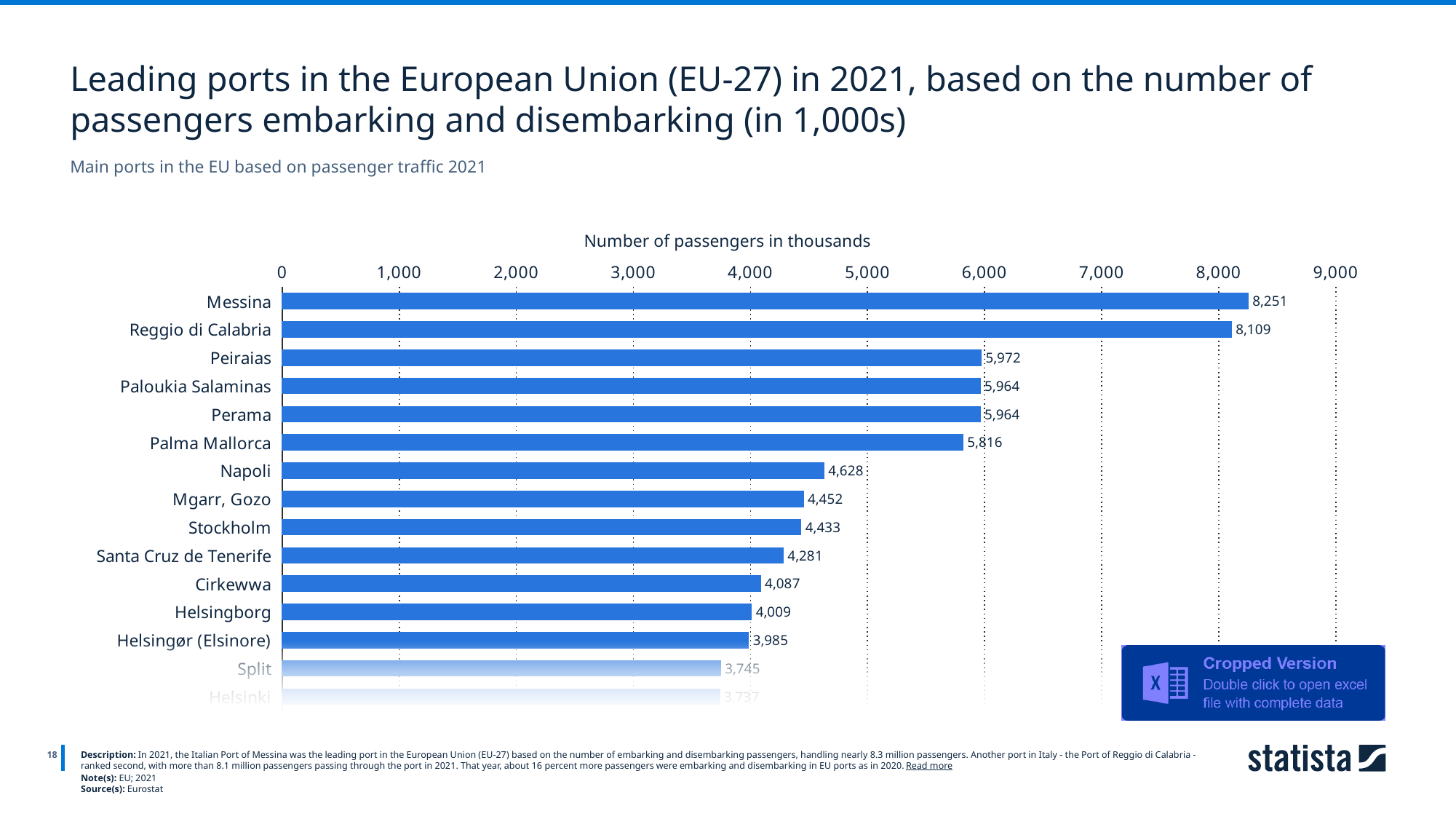
What is the value shown for Helsingør (Elsinore)? 3,985 What kind of chart is shown on the slide? Bar chart Which has a larger value, Helsingborg or Helsingør (Elsinore)? Helsingborg Which port has the highest number of passengers in the chart? Messina Which has a larger value, Peiraias or Palma Mallorca? Peiraias What is the value shown for Santa Cruz de Tenerife? 4,281 What is the title of the horizontal axis of the chart? Number of passengers in thousands Is the value for Cirkewwa greater or less than 5,000? less What is the value shown for Palma Mallorca? 5,816 What is the difference between the values for Napoli and Stockholm? 195 What is the difference between the values for Messina and Reggio di Calabria? 142 What is the number of passengers (in thousands) for Messina? 8,251